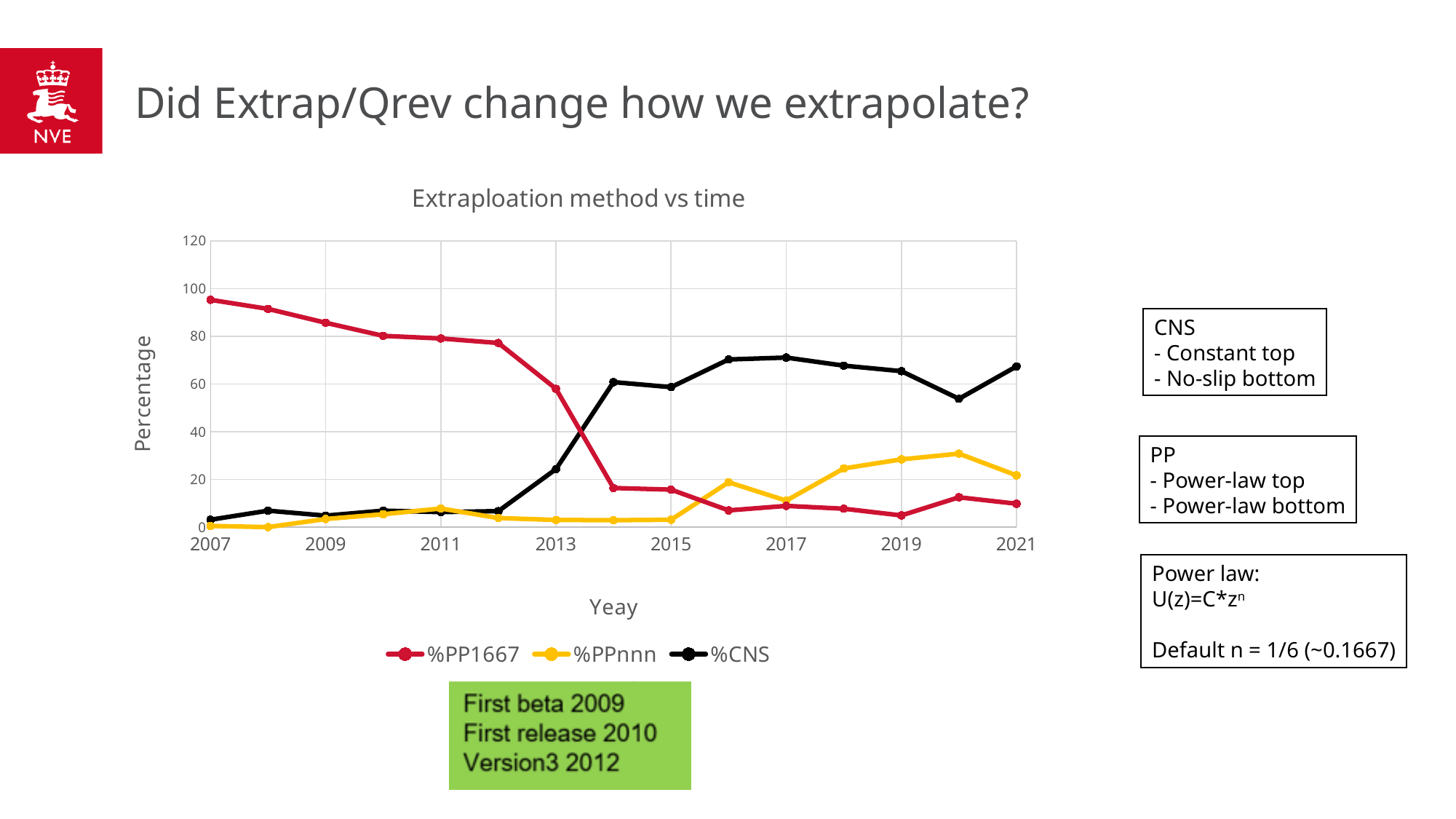
Is the value for %CNS in 2017 greater or less than 60? greater How many yearly data points does each series have, from 2007 to 2021? 15 How many series does the legend list? 3 Is the value for %PP1667 in 2007 greater or less than 80? greater Is the value for %PPnnn in 2020 greater or less than 20? greater What kind of chart is shown on the slide? line chart Which series has the lowest value in 2013? %PPnnn Which series has the highest value in 2007? %PP1667 In 2021, which is larger: %CNS or %PP1667? %CNS Does the %PP1667 series rise or fall between 2007 and 2014? fall What is the title of the chart? Extraploation method vs time